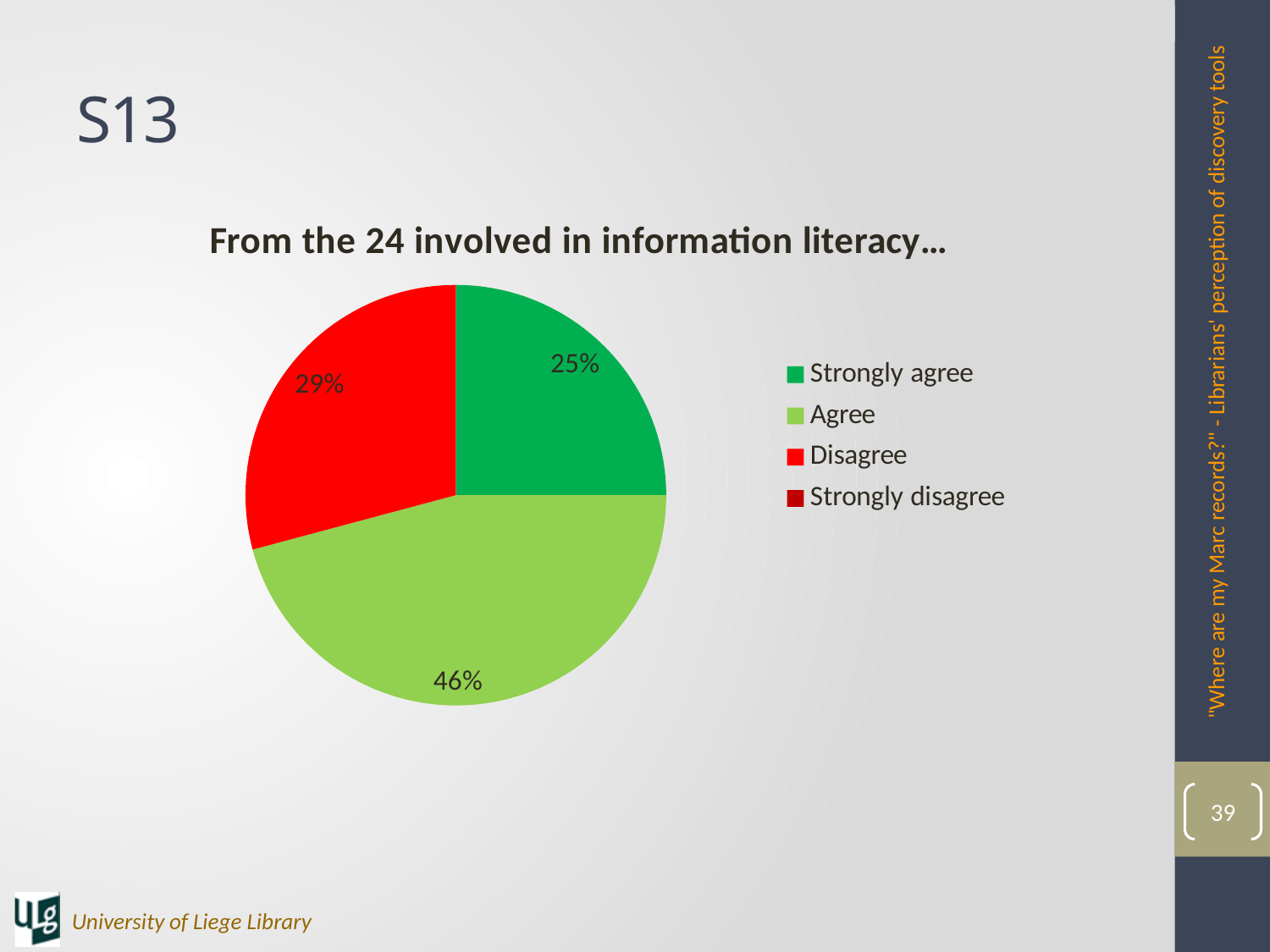
How many entries does the legend list? 4 What is the title of the chart? From the 24 involved in information literacy… What share of the pie is labelled for Agree? 46% How many slices with percentage labels are visible in the pie? 3 Which category has the largest slice of the pie? Agree Which of the labelled slices is the smallest? Strongly agree Which slice is larger, Disagree or Strongly agree? Disagree What share of the pie is labelled for Strongly agree? 25% What colour is the Agree slice? light green What kind of chart is shown on the slide? pie chart What share of the pie is labelled for Disagree? 29% What is the difference in percentage points between the Agree slice and the Disagree slice? 17